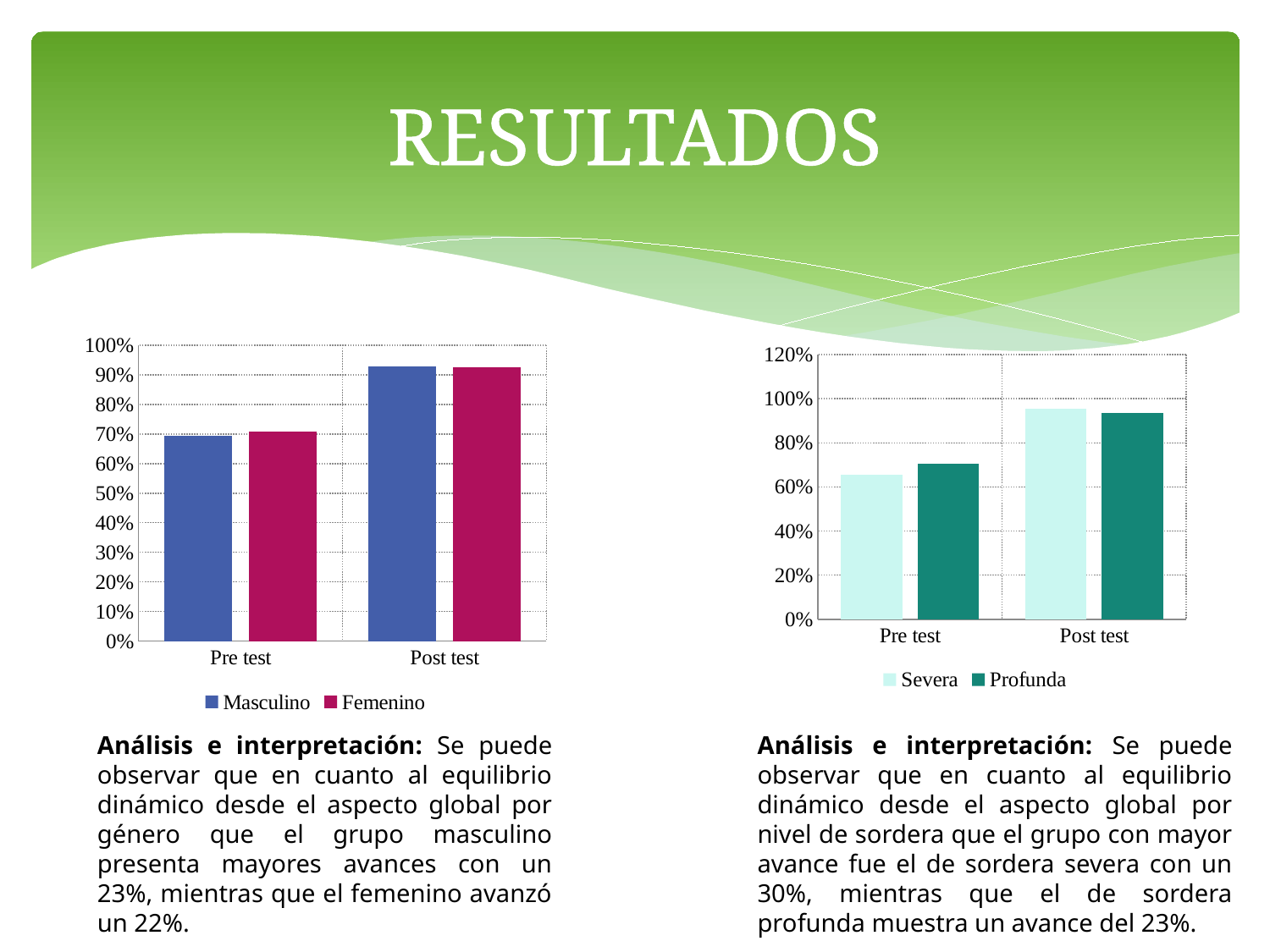
How many series does the legend of the left chart list? 2 In the left chart, is the value for Masculino in Pre test greater or less than 80%? less In the right chart, which is larger in Pre test, Severa or Profunda? Profunda Which series does the legend of the left chart list? Masculino and Femenino How many categories are shown on the x axis of the left chart? 2 In the left chart, is the value for Masculino in Post test greater or less than 80%? greater What kind of chart is the chart on the left of the slide? bar chart In the left chart, do the values for Femenino rise or fall from Pre test to Post test? rise Which series does the legend of the right chart list? Severa and Profunda In the right chart, is the value for Severa in Pre test greater or less than 80%? less How many series does the legend of the right chart list? 2